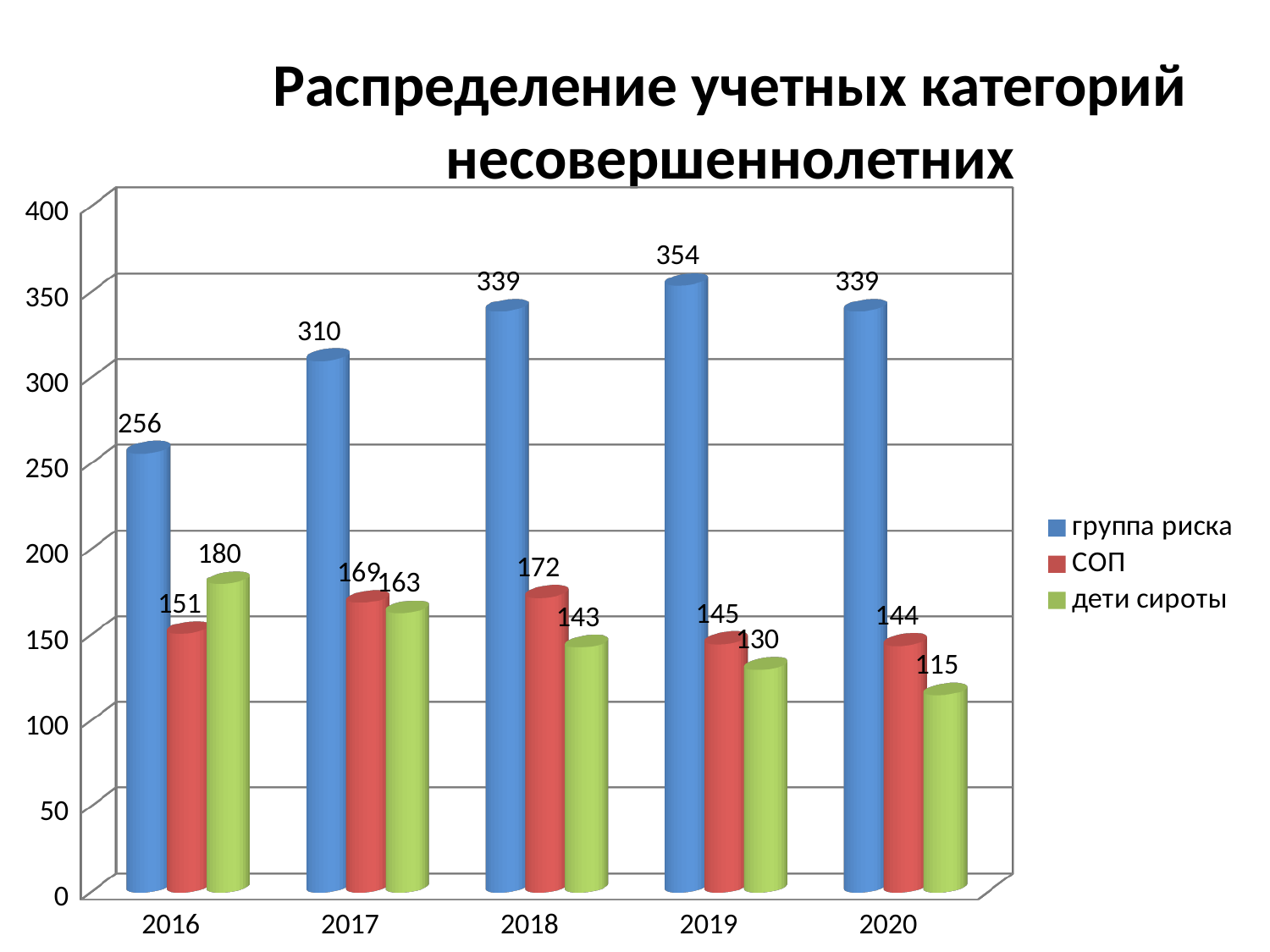
What is the value for дети сироты in 2016? 180 How many series does the legend list? 3 In which year is the value for дети сироты lowest? 2020 How many years are shown on the x axis? 5 Which is larger in 2017: СОП or дети сироты? СОП What kind of chart is shown on the slide? bar chart Do the values for дети сироты rise or fall from 2016 to 2020? fall What is the difference between the группа риска values for 2019 and 2016? 98 In which year is the value for группа риска highest? 2019 Is the value for группа риска in 2017 greater or less than 300? greater What is the value for группа риска in 2019? 354 What is the value for СОП in 2018? 172